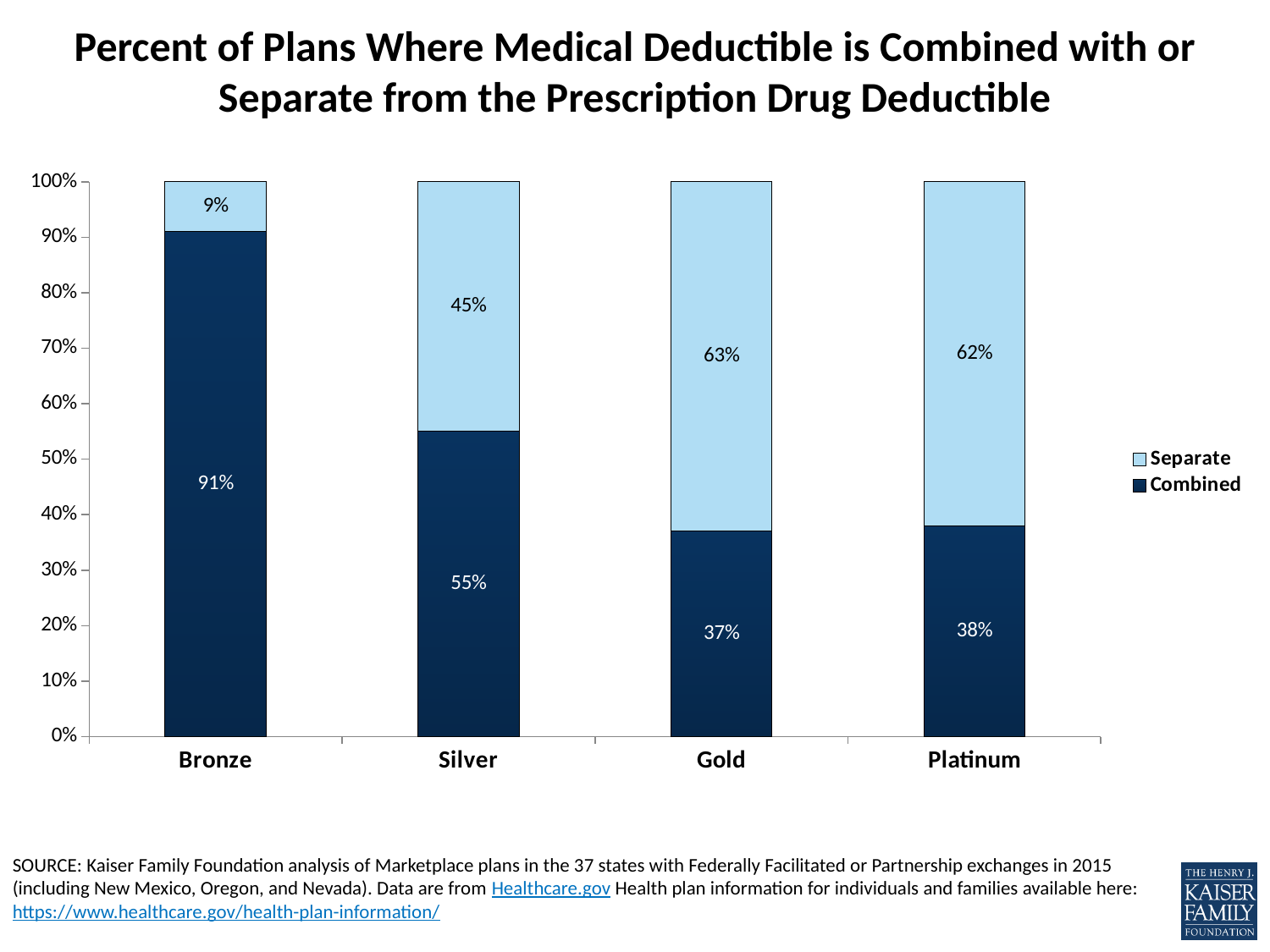
How many series does the legend list? 2 Which metal level has the lowest share of plans with a Combined deductible? Gold Is the Combined value for Silver greater or less than 50%? greater What kind of chart is shown on the slide? Stacked bar chart What percent of Silver plans have a Separate deductible? 45% What percent of Platinum plans have a Combined deductible? 38% Which is larger: the Separate share for Silver or the Separate share for Platinum? Platinum What is the difference between the Combined percentages for Bronze and Silver? 36 percentage points Which metal level has the highest share of plans with a Combined deductible? Bronze How many metal levels are shown on the x axis? 4 What percent of Bronze plans have a Combined deductible? 91% What percent of Gold plans have a Separate deductible? 63%